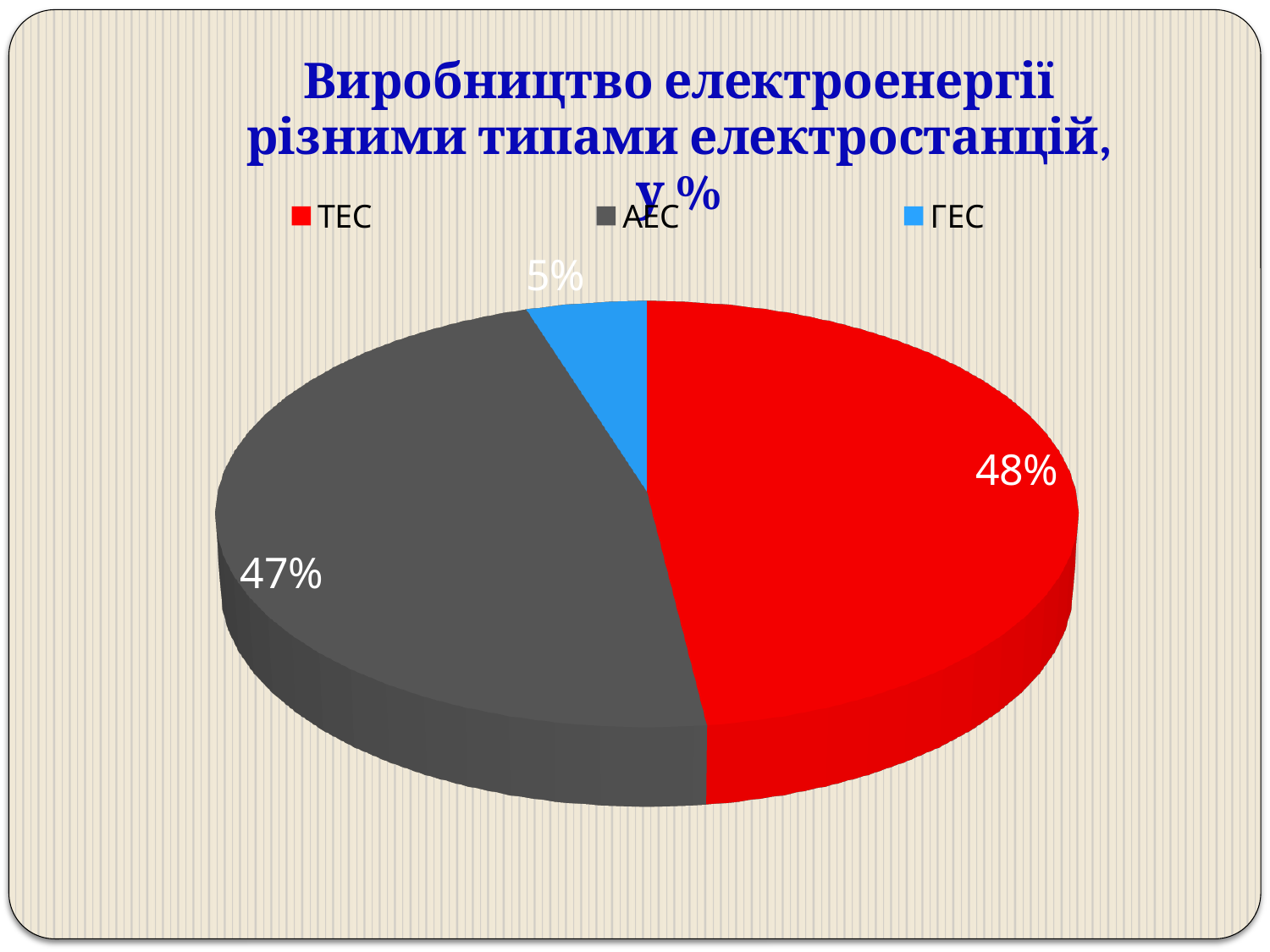
Which type of power station has the largest share in the pie chart? ТЕС What colour is the slice representing ГЕС? Blue What kind of chart is shown on the slide? Pie chart Which has a larger share, ТЕС or АЕС? ТЕС What share of electricity production does АЕС account for? 47% What share of electricity production does ГЕС account for? 5% Which has a larger share, АЕС or ГЕС? АЕС By how many percentage points does the ТЕС share exceed the ГЕС share? 43 percentage points How many slices does the pie chart have? 3 What share of electricity production does ТЕС account for? 48% Which type of power station has the smallest share in the pie chart? ГЕС By how many percentage points does the ТЕС share exceed the АЕС share? 1 percentage point